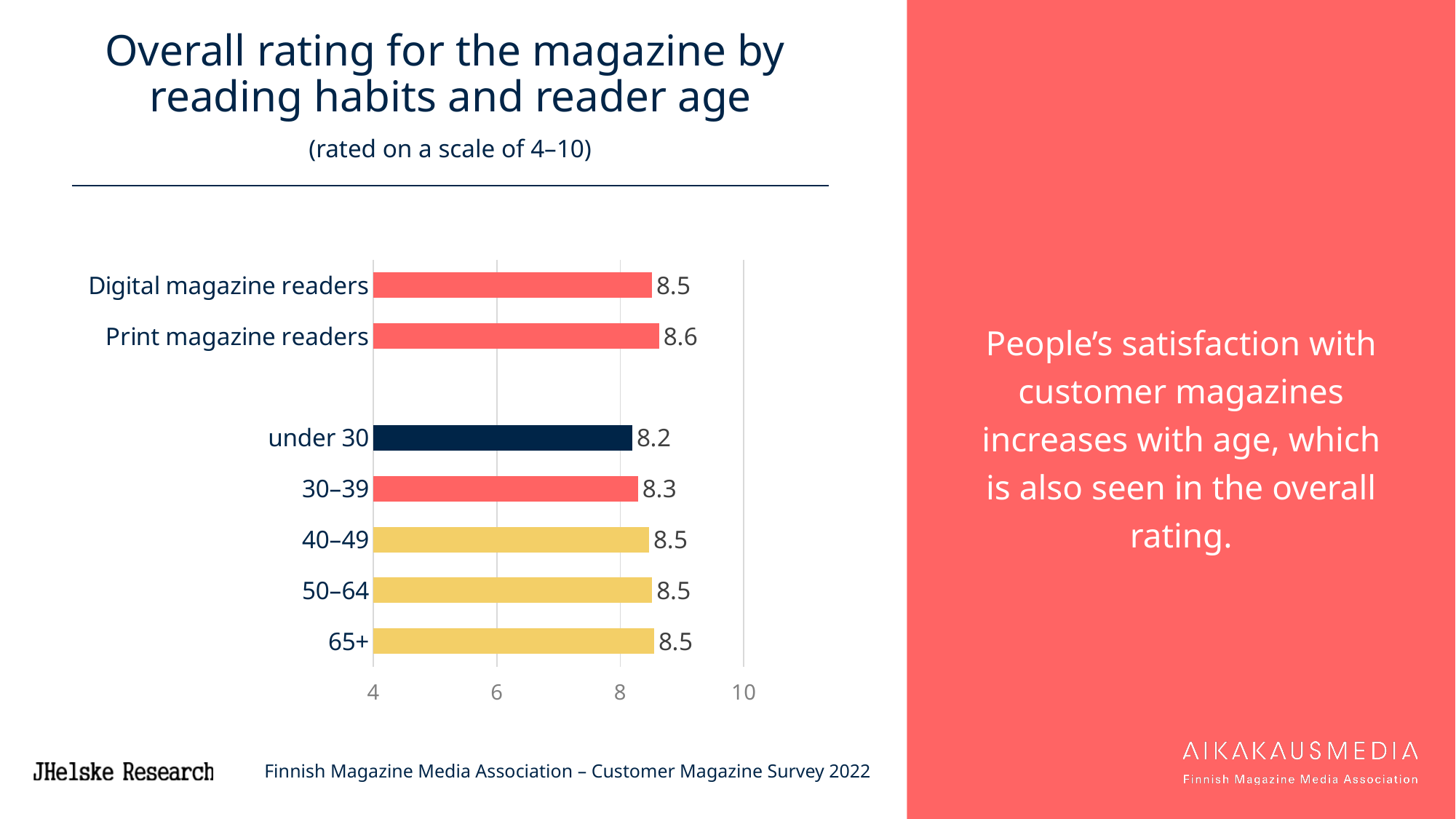
Which has a higher rating, the 30–39 age group or the 40–49 age group? 40–49 What is the overall rating for Print magazine readers? 8.6 How many categories are plotted in the chart? 7 What kind of chart is shown on the slide? Bar chart Which category has the lowest overall rating? under 30 What is the rating scale stated in the chart subtitle? 4–10 What is the overall rating for the 30–39 age group? 8.3 Is the value for the 65+ age group greater or less than 8? greater Which category has the highest overall rating? Print magazine readers What is the difference between the ratings for Print magazine readers and readers under 30? 0.4 What is the overall rating for Digital magazine readers? 8.5 What is the overall rating for readers under 30? 8.2